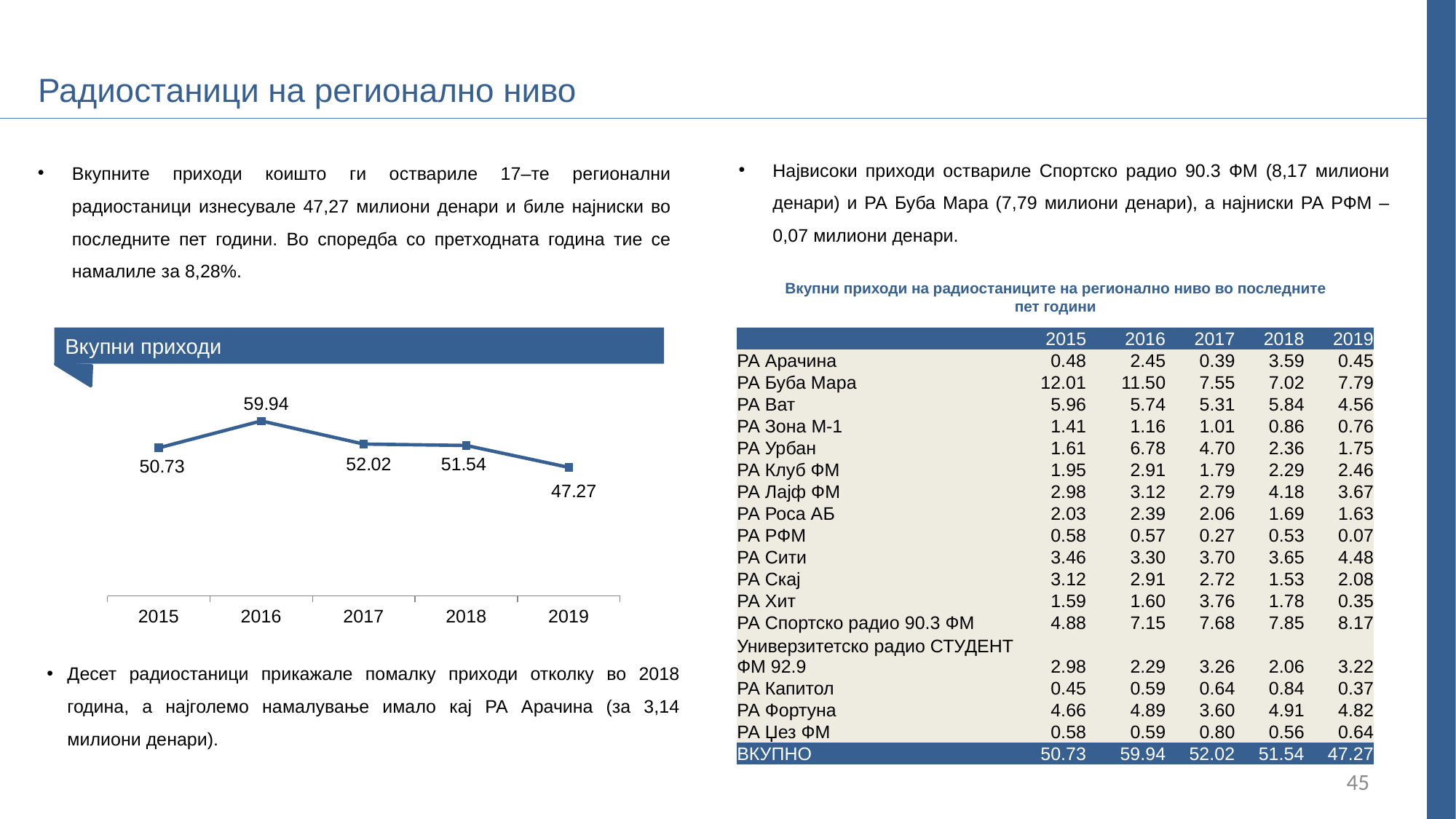
Which year has the highest value in the "Вкупни приходи" chart? 2016 What is the difference between the 2016 and 2019 values in the "Вкупни приходи" chart? 12.67 What is the title shown above the line chart on the slide? Вкупни приходи What is the value plotted for 2016 in the "Вкупни приходи" chart? 59.94 What is the value plotted for 2015 in the "Вкупни приходи" chart? 50.73 Which year has the lowest value in the "Вкупни приходи" chart? 2019 What is the value plotted for 2019 in the "Вкупни приходи" chart? 47.27 In the "Вкупни приходи" chart, do the values rise or fall from 2016 to 2019? Fall In the "Вкупни приходи" chart, is the value for 2015 or 2017 larger? 2017 What type of chart is shown under the heading "Вкупни приходи"? Line chart How many years are plotted on the x axis of the "Вкупни приходи" chart? 5 What is the difference between the 2017 and 2018 values in the "Вкупни приходи" chart? 0.48